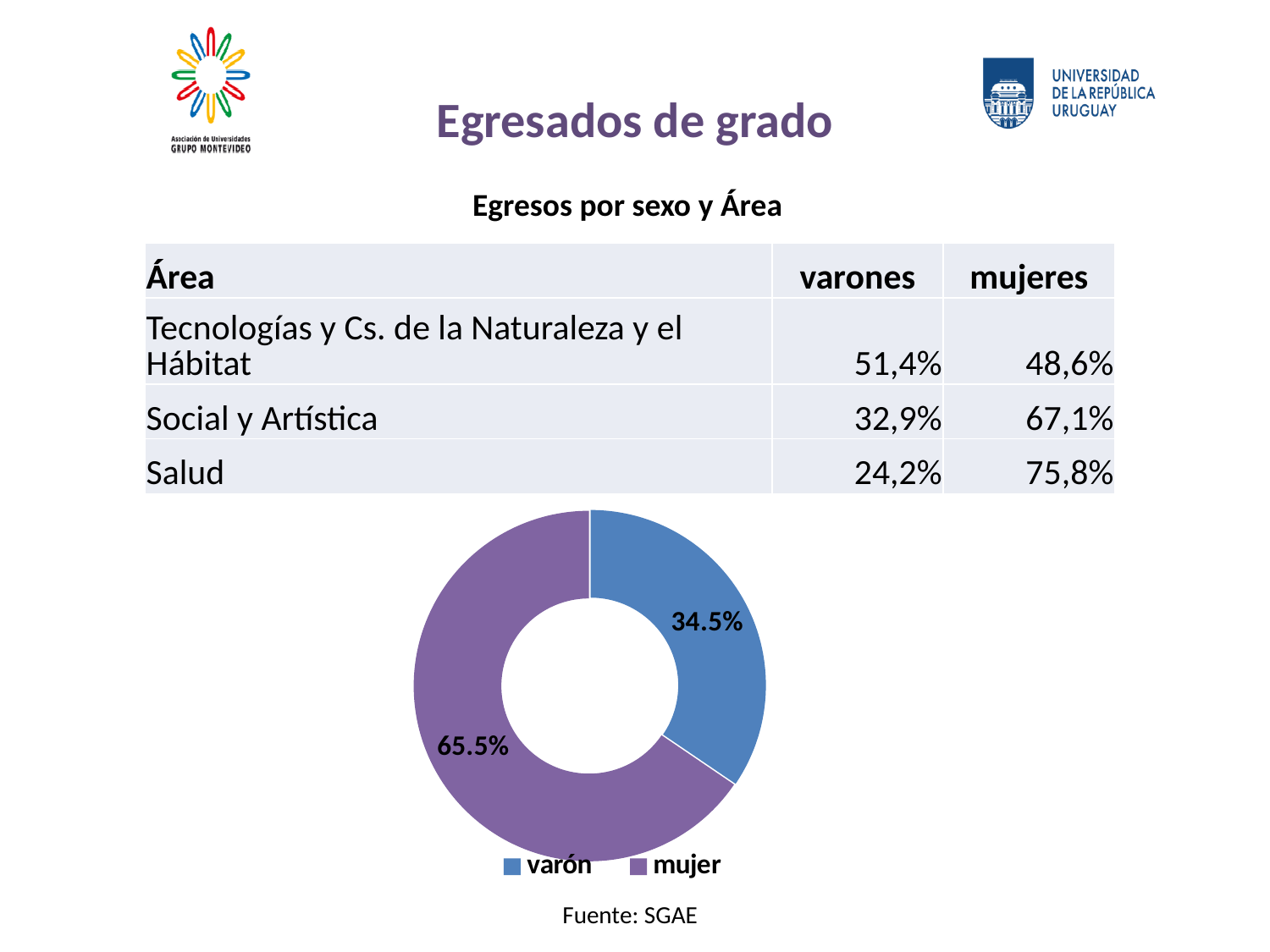
What share of the chart does the mujer slice represent? 65.5% How many entries does the chart's legend list? 2 What kind of chart is shown on the slide? doughnut chart What colour is the varón slice in the chart? blue What percentage does the chart show for mujer? 65.5% How many slices does the chart have? 2 Which category has the largest slice in the chart? mujer By how many percentage points does the mujer slice exceed the varón slice? 31 percentage points What percentage does the chart show for varón? 34.5% Which category has the smallest slice in the chart? varón What are the two entries in the chart's legend? varón and mujer Which is larger in the chart, varón or mujer? mujer